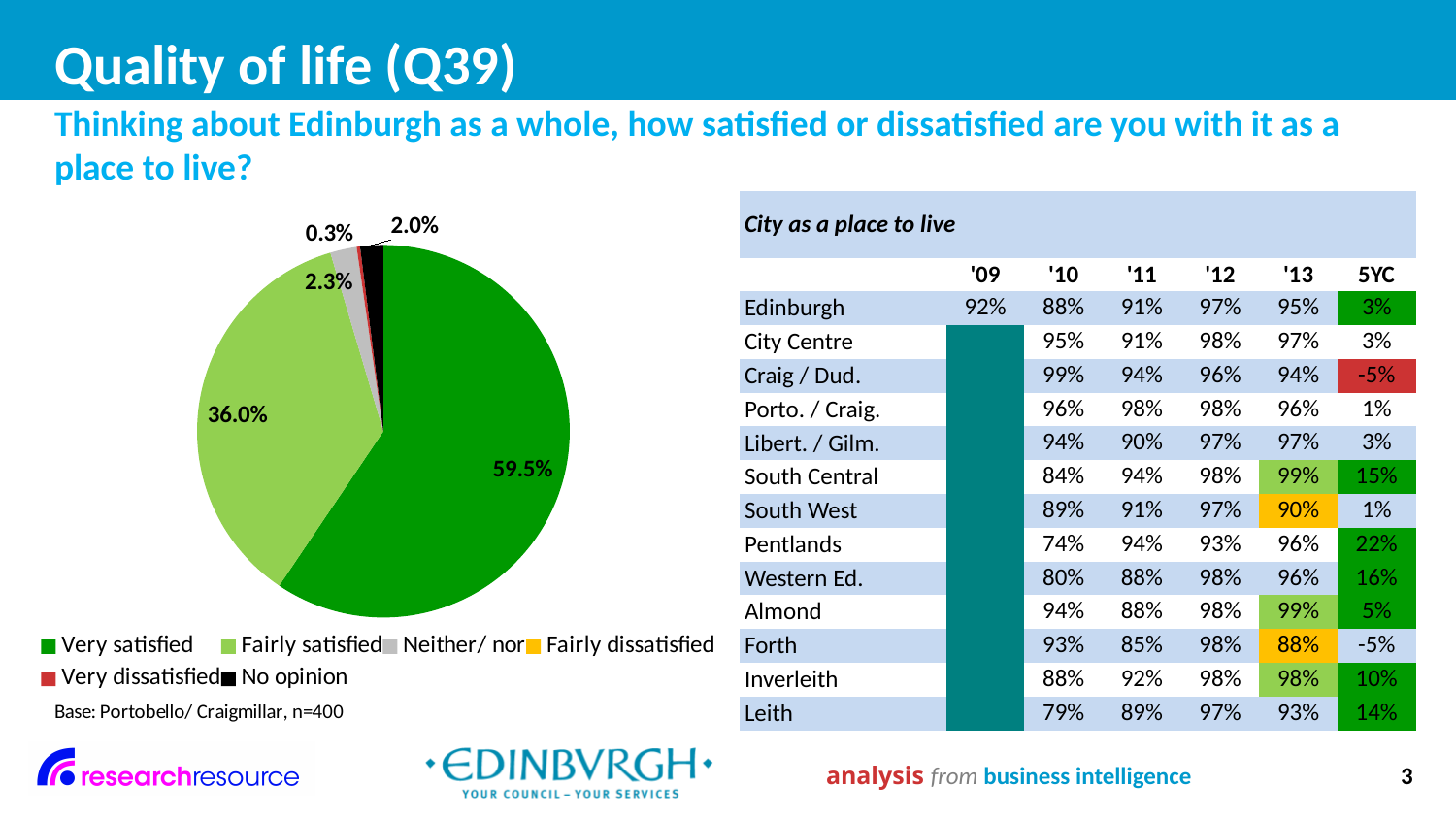
What is the smallest value labelled on the pie chart? 0.3% What percentage of respondents are 'Very satisfied' in the pie chart? 59.5% What kind of chart is shown on the slide? Pie chart What percentage is shown for 'Neither/ nor' in the pie chart? 2.3% What is the base sample size stated below the pie chart? n=400 What is the combined share of 'Very satisfied' and 'Fairly satisfied' in the pie chart? 95.5% What is the difference between the 'Very satisfied' and 'Fairly satisfied' shares in the pie chart? 23.5% What percentage is shown for 'No opinion' in the pie chart? 2.0% What percentage of respondents are 'Fairly satisfied' in the pie chart? 36.0% Which is larger in the pie chart, 'Neither/ nor' or 'No opinion'? Neither/ nor How many categories does the pie chart legend list? 6 Which category has the largest slice of the pie chart? Very satisfied